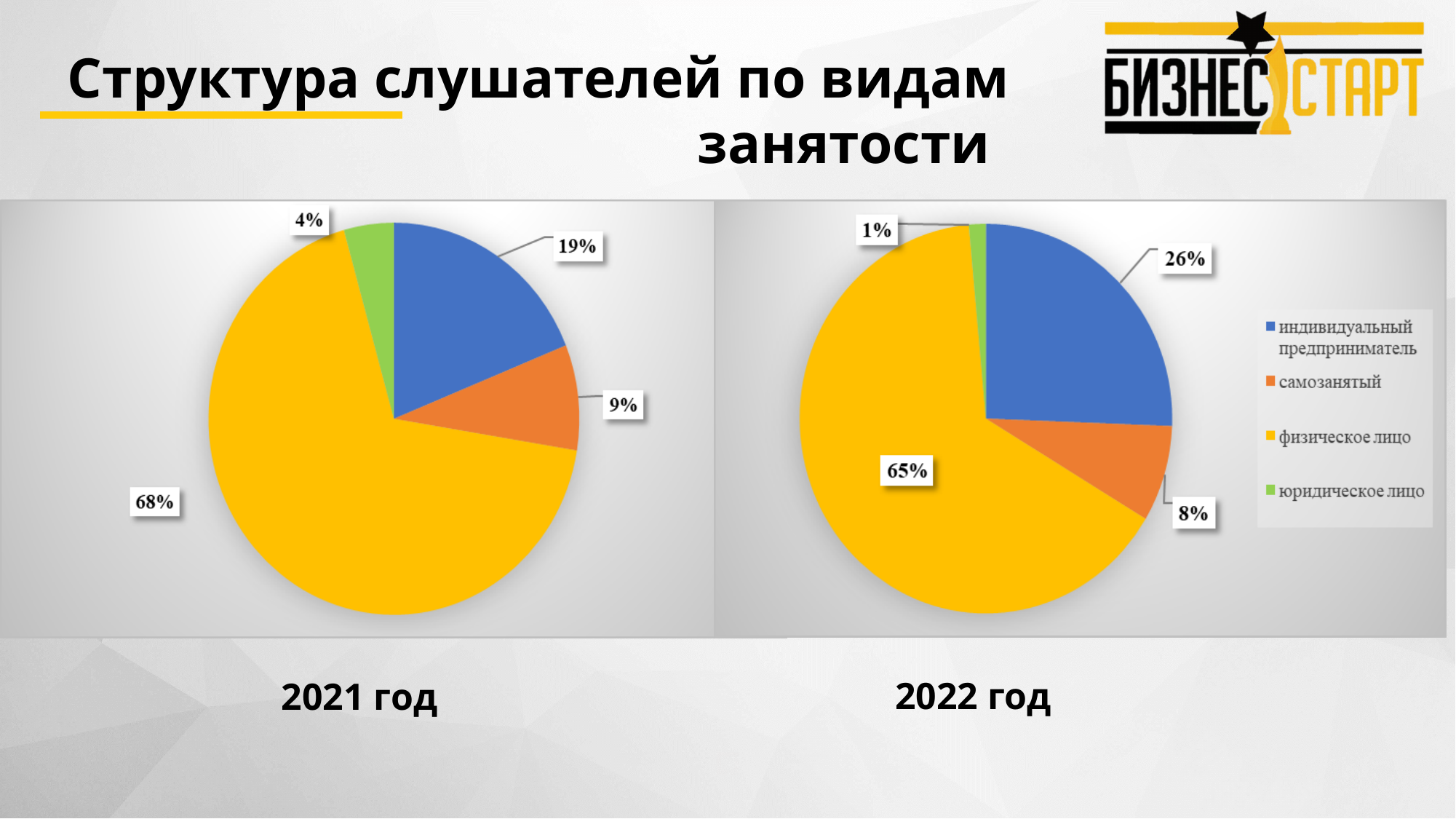
Какого типа диаграмма «2021 год»? круговая диаграмма На диаграмме «2022 год» какую долю составляют индивидуальные предприниматели? 26% Сколько категорий перечислено в легенде? 4 На диаграмме «2021 год» что больше: доля индивидуальных предпринимателей или доля самозанятых? индивидуальный предприниматель На диаграмме «2021 год» какую долю составляют физические лица? 68% Сколько категорий показано на диаграмме «2022 год»? 4 Каким цветом на диаграммах обозначена категория «самозанятый»? оранжевым На диаграмме «2022 год» какую долю составляют юридические лица? 1% На диаграмме «2021 год» какая категория имеет наибольшую долю? физическое лицо На диаграмме «2021 год» какую долю составляют самозанятые? 9% На сколько процентных пунктов доля индивидуальных предпринимателей на диаграмме «2022 год» больше, чем на диаграмме «2021 год»? 7 На диаграмме «2022 год» какая категория имеет наименьшую долю? юридическое лицо